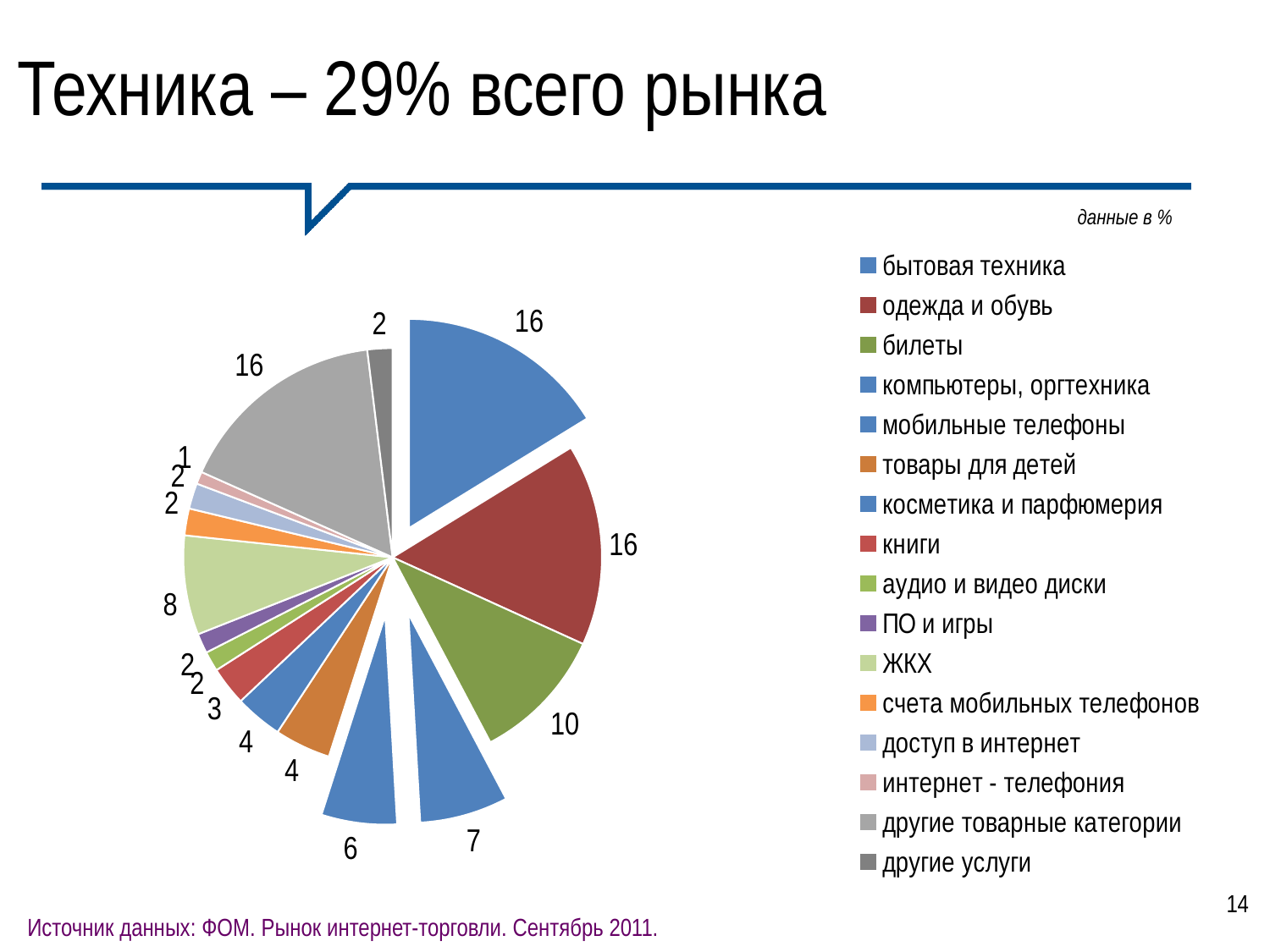
What is the value for мобильные телефоны? 6 What is the difference between the values for бытовая техника and компьютеры, оргтехника? 9 What is the value for компьютеры, оргтехника? 7 What is the title of the slide containing the chart? Техника – 29% всего рынка What is the value for билеты? 10 What is the value for ЖКХ? 8 Which category has the smallest slice of the pie? интернет - телефония What is the value for книги? 3 How many categories does the legend list? 16 What type of chart is shown on the slide? pie chart Which is larger, билеты or ЖКХ? билеты What is the value for другие товарные категории? 16